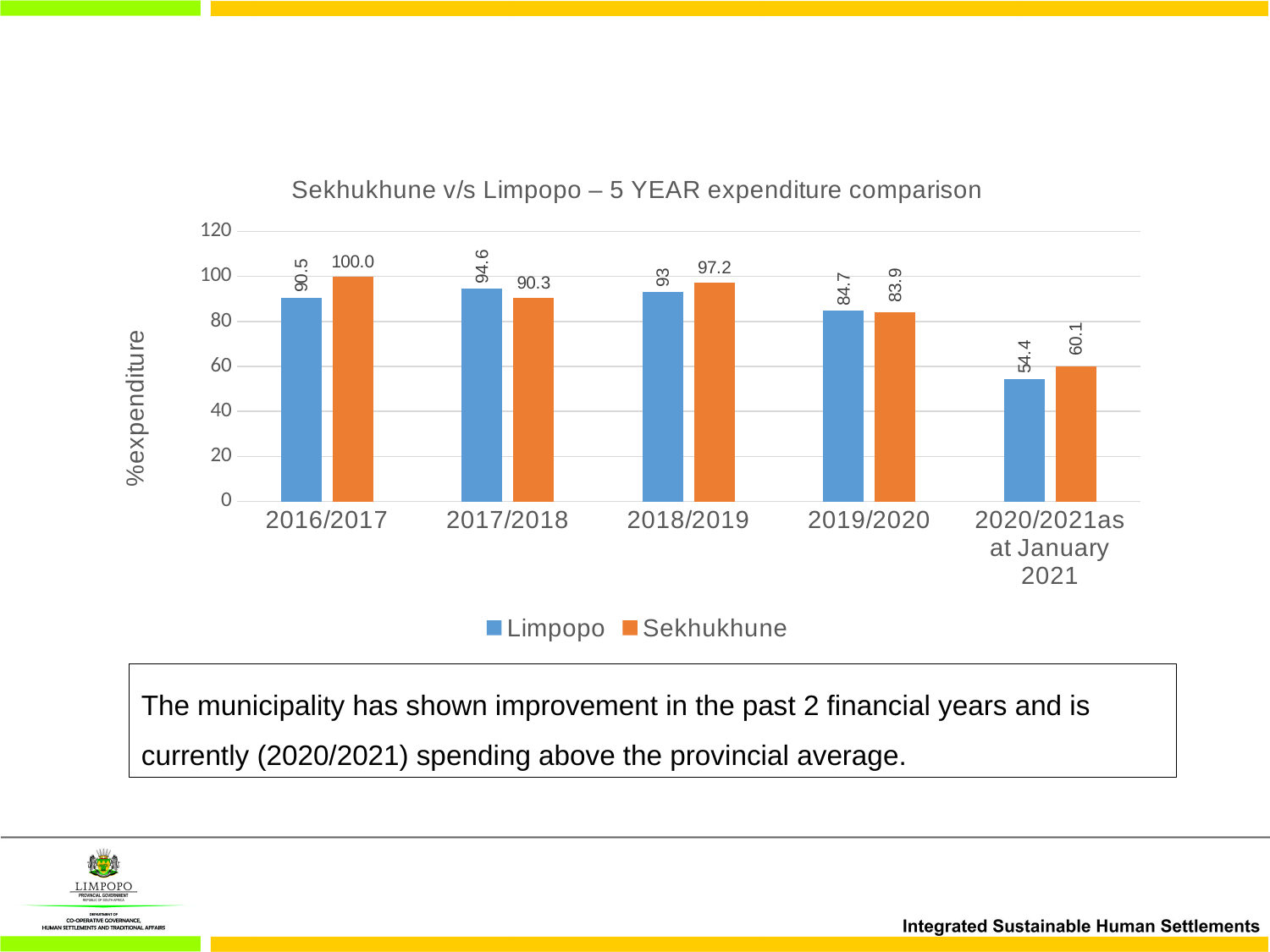
What is the Limpopo value for 2020/2021 as at January 2021? 54.4 How many financial years are shown on the x axis? 5 What is the Sekhukhune value for 2016/2017? 100.0 What is the difference between the Sekhukhune and Limpopo values in 2016/2017? 9.5 What is the Limpopo value for 2017/2018? 94.6 How many series does the legend list? 2 In which year is the Sekhukhune value highest? 2016/2017 What is the title of the chart? Sekhukhune v/s Limpopo – 5 YEAR expenditure comparison What kind of chart is shown? Bar chart What is the Sekhukhune value for 2018/2019? 97.2 Which is larger in 2017/2018, Limpopo or Sekhukhune? Limpopo In which year is the Sekhukhune value lowest? 2020/2021as at January 2021